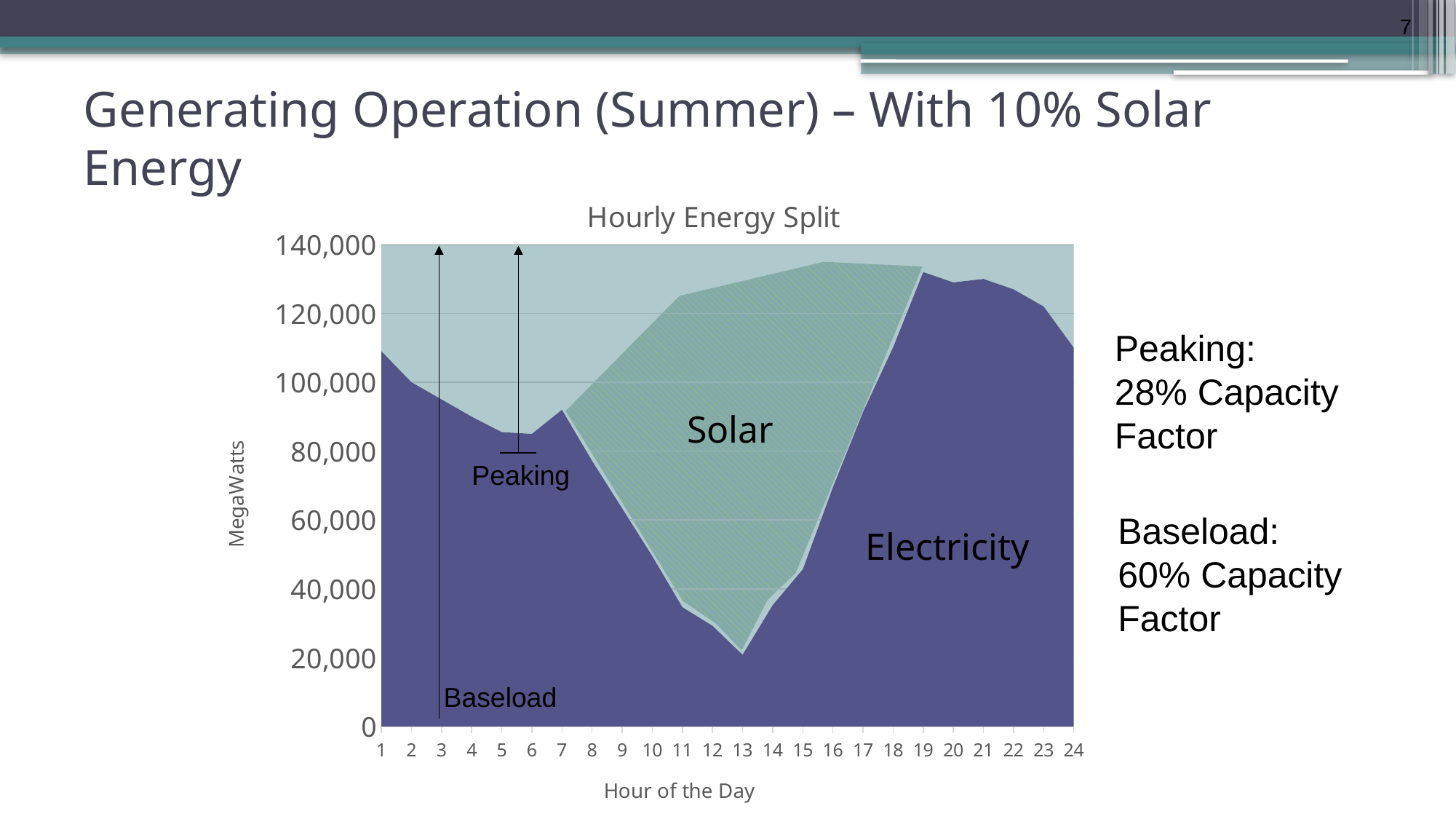
How many hours are shown along the x axis of the chart? 24 Is the Electricity value at hour 6 greater or less than 100,000? less What kind of chart is shown on the slide? area chart Which is larger, the Electricity value at hour 1 or at hour 13? hour 1 What is the title of the chart? Hourly Energy Split Is the Electricity value at hour 13 greater or less than 40,000? less Is the Electricity value at hour 1 greater or less than 100,000? greater Does the Electricity area rise or fall from hour 7 to hour 13? fall Does the Electricity area rise or fall from hour 13 to hour 19? rise At which hour of the day is the Electricity area at its lowest? 13 What is the label of the vertical axis of the chart? MegaWatts